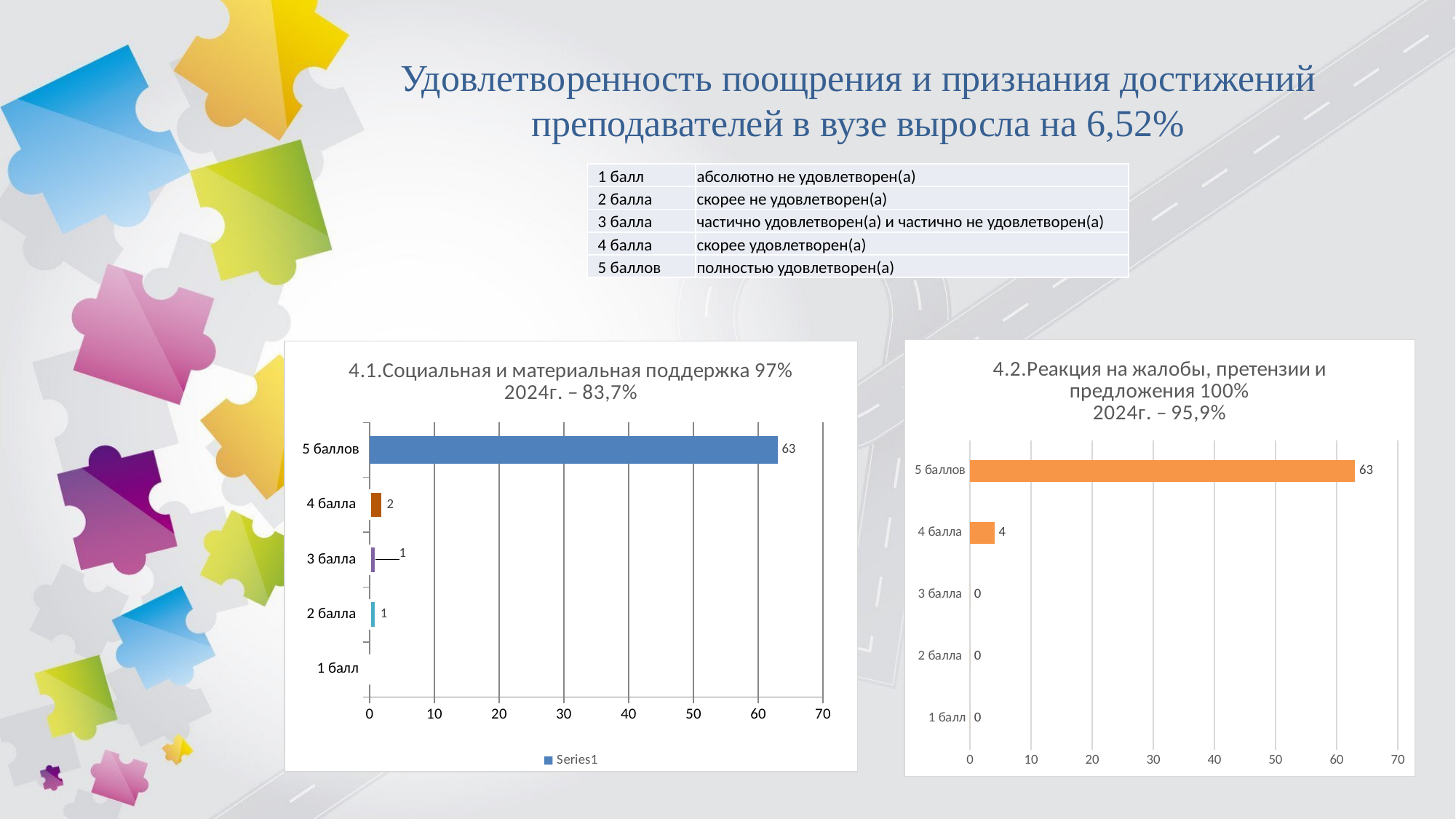
In the chart '4.1.Социальная и материальная поддержка', how many series does the legend list? 1 In the chart '4.1.Социальная и материальная поддержка', what is the value for 5 баллов? 63 In the chart '4.1.Социальная и материальная поддержка', what is the difference between the values for 5 баллов and 4 балла? 61 In the chart '4.2.Реакция на жалобы, претензии и предложения', what is the value for 3 балла? 0 In the chart '4.1.Социальная и материальная поддержка', what is the value for 4 балла? 2 In the chart '4.2.Реакция на жалобы, претензии и предложения', how many categories are shown on the vertical axis? 5 Which is larger: the value for 4 балла in chart 4.1 or the value for 4 балла in chart 4.2? chart 4.2 In the chart '4.1.Социальная и материальная поддержка', which category has the highest value? 5 баллов In the chart '4.2.Реакция на жалобы, претензии и предложения', which category has the highest value? 5 баллов What type of chart is the chart on the right side of the slide? bar chart In the chart '4.1.Социальная и материальная поддержка', what is the value for 3 балла? 1 In the chart '4.2.Реакция на жалобы, претензии и предложения', what is the value for 4 балла? 4